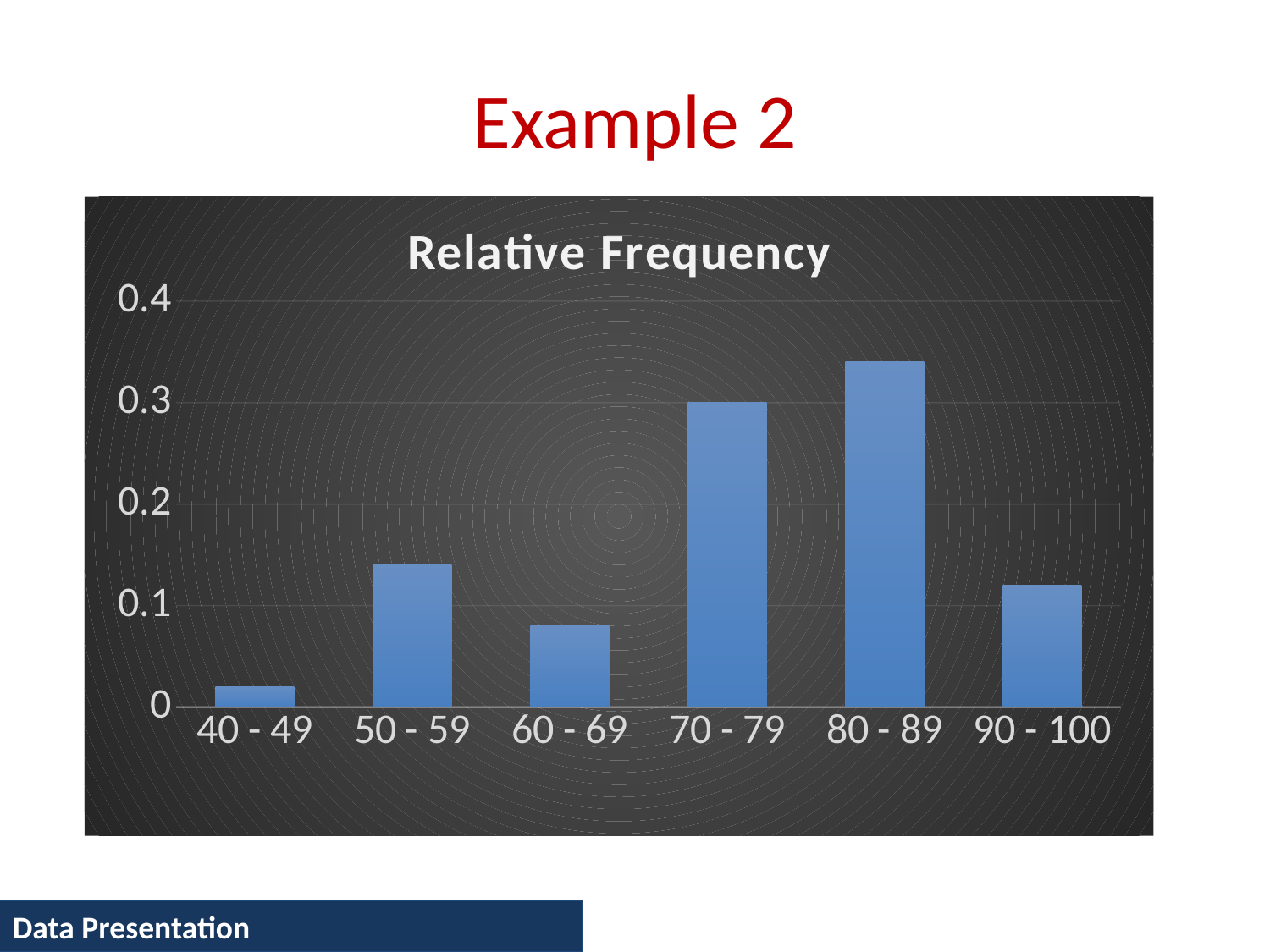
Is the value for 40 - 49 greater or less than 0.1? less How many categories are shown on the x axis of the chart? 6 What is the title of the chart? Relative Frequency Which category has the highest relative frequency? 80 - 89 Is the value for 60 - 69 greater or less than 0.1? less Which category has the larger relative frequency, 50 - 59 or 60 - 69? 50 - 59 What colour are the bars in the chart? blue Is the value for 80 - 89 greater or less than 0.3? greater Which category has the lowest relative frequency? 40 - 49 What kind of chart is shown on the slide? bar chart